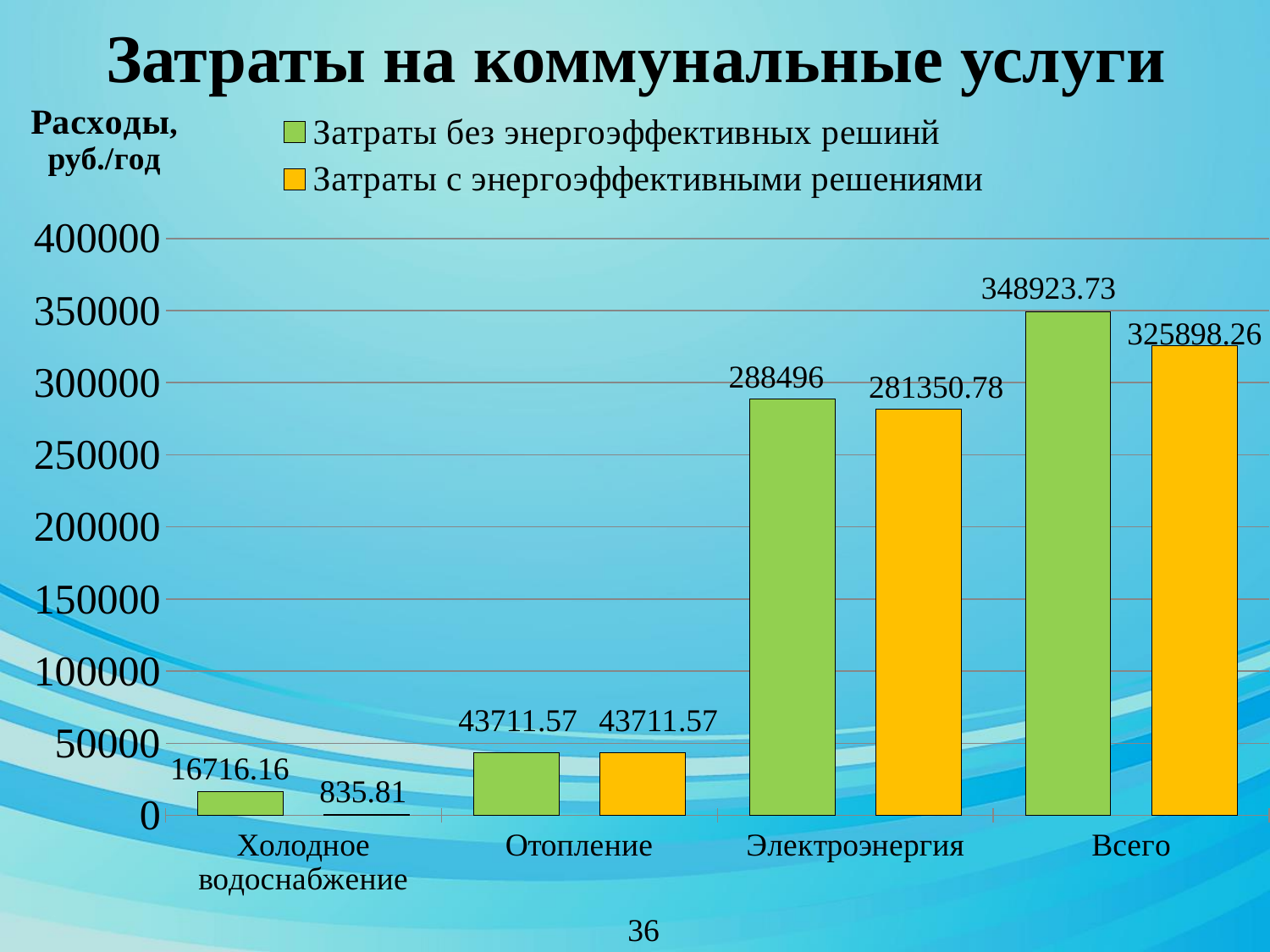
What is the value for Всего in the series Затраты с энергоэффективными решениями? 325898.26 How many categories are shown on the x axis? 4 What is the value for Электроэнергия in the series Затраты без энергоэффективных решиний? 288496 What is the value for Холодное водоснабжение in the series Затраты с энергоэффективными решениями? 835.81 What is the title of the chart? Затраты на коммунальные услуги What type of chart is shown on the slide? bar chart What is the difference between the two series for Всего? 23025.47 Which category has the lowest value in the series Затраты с энергоэффективными решениями? Холодное водоснабжение What is the difference between the two series for Электроэнергия? 7145.22 How many series does the legend list? 2 For Отопление, which series has the larger value, or are they equal? equal Which category has the highest value in the series Затраты без энергоэффективных решиний? Всего